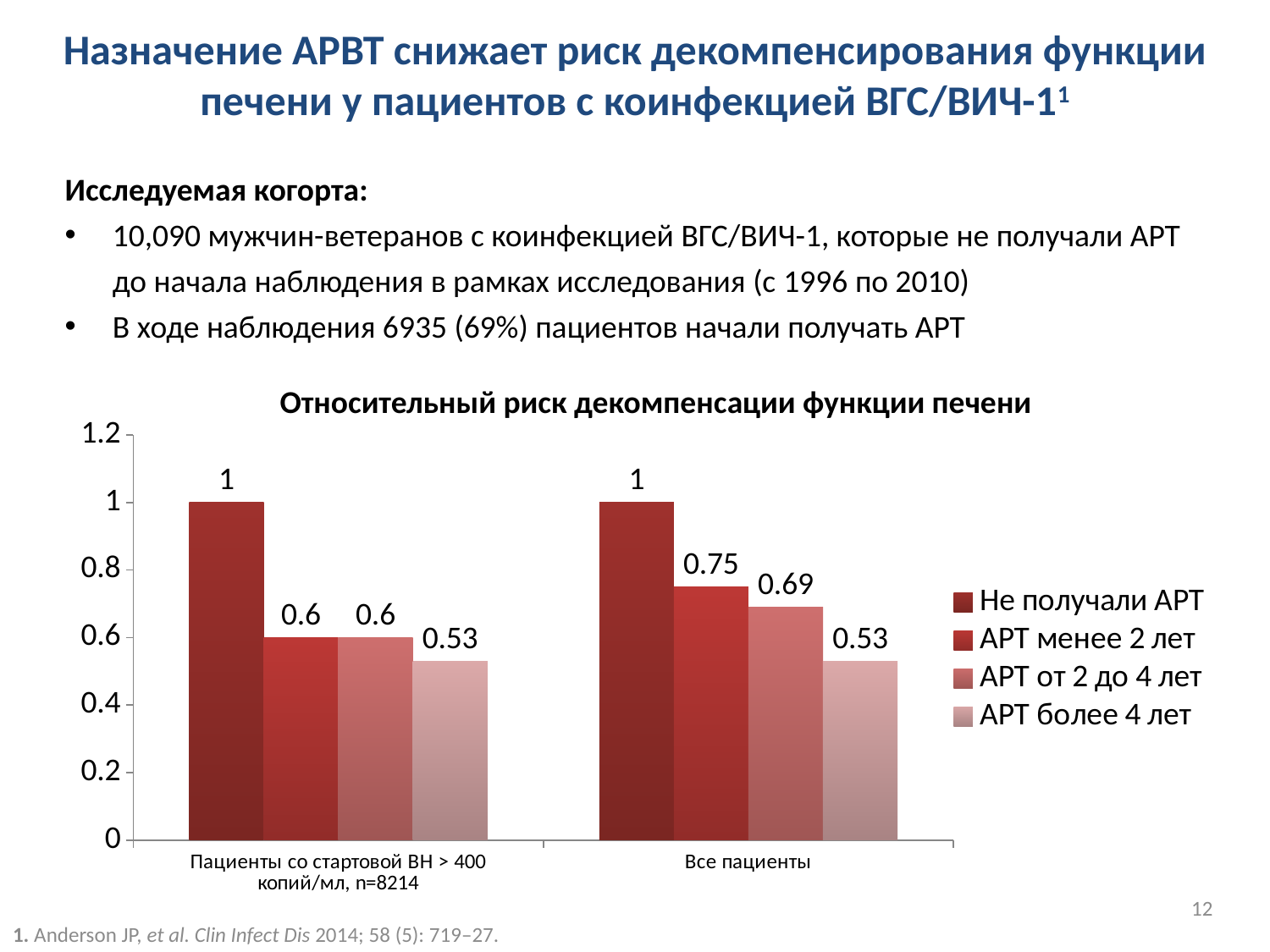
Which series has the highest value in the 'Пациенты со стартовой ВН > 400 копий/мл, n=8214' group? Не получали АРТ How many series does the legend list? 4 Which series has the lowest value in the 'Все пациенты' group? АРТ более 4 лет What is the value for 'АРТ от 2 до 4 лет' in the 'Все пациенты' group? 0.69 Which is larger in the 'Все пациенты' group: 'АРТ менее 2 лет' or 'АРТ от 2 до 4 лет'? АРТ менее 2 лет What is the difference between 'Не получали АРТ' and 'АРТ более 4 лет' in the 'Все пациенты' group? 0.47 What is the value for 'АРТ менее 2 лет' in the 'Все пациенты' group? 0.75 What kind of chart is shown on the slide? Bar chart What is the title of the chart? Относительный риск декомпенсации функции печени What is the value for 'Не получали АРТ' in the 'Все пациенты' group? 1 How many category groups are shown on the x axis? 2 What is the value for 'АРТ более 4 лет' in the 'Пациенты со стартовой ВН > 400 копий/мл, n=8214' group? 0.53